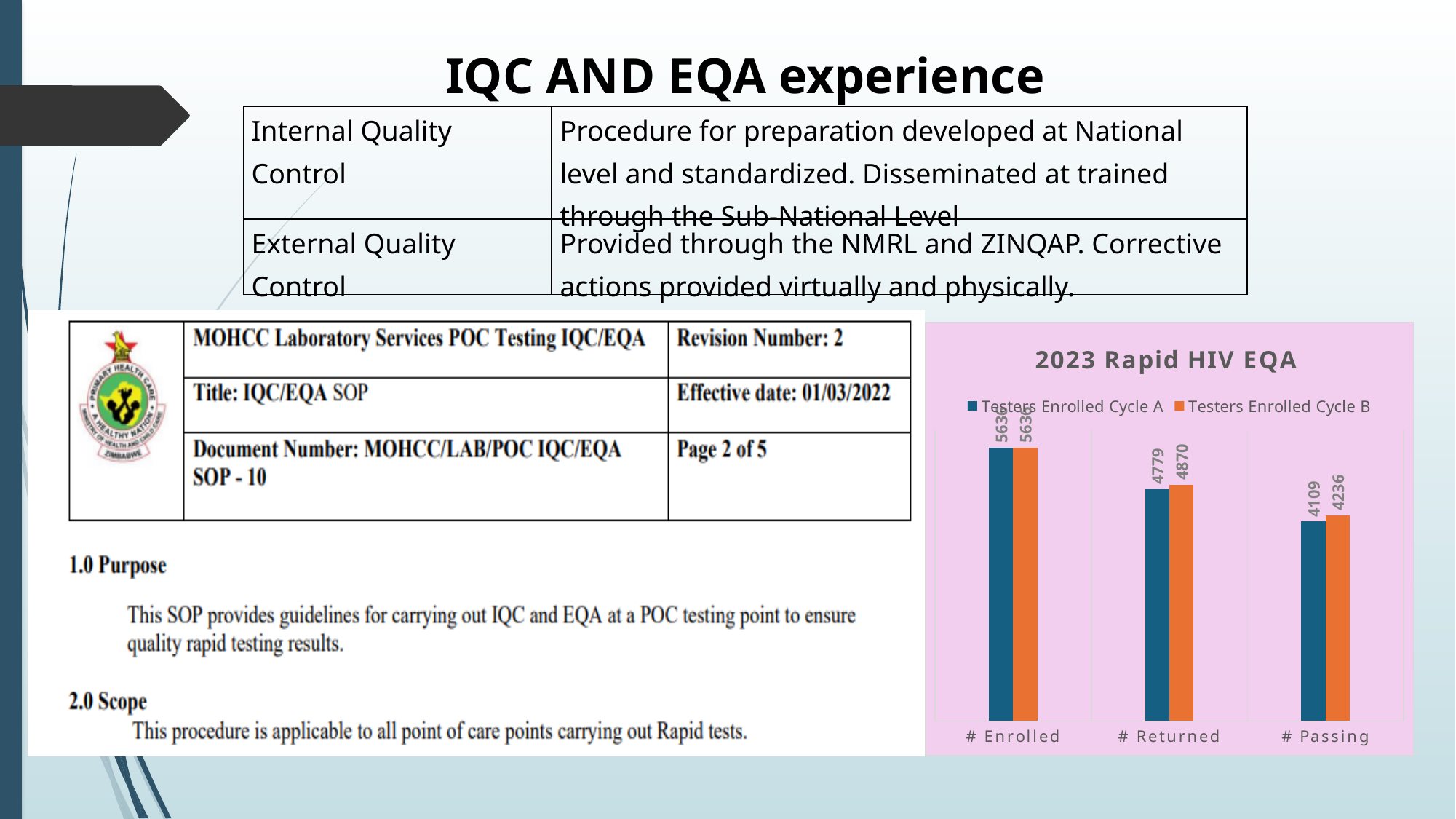
What is the difference between Testers Enrolled Cycle B and Testers Enrolled Cycle A in the # Returned category? 91 How many series does the chart legend list? 2 Do the values for Testers Enrolled Cycle A rise or fall from # Enrolled to # Passing? fall Which category has the lowest value for Testers Enrolled Cycle B? # Passing How many categories are shown on the x axis of the chart? 3 What is the value for Testers Enrolled Cycle B in the # Passing category? 4236 What is the value for Testers Enrolled Cycle A in the # Returned category? 4779 What is the title of the chart on the slide? 2023 Rapid HIV EQA In the # Passing category, which series has the larger value, Testers Enrolled Cycle A or Testers Enrolled Cycle B? Testers Enrolled Cycle B What is the value for Testers Enrolled Cycle A in the # Enrolled category? 5636 Which category has the highest value for Testers Enrolled Cycle A? # Enrolled What type of chart is shown on the slide? bar chart